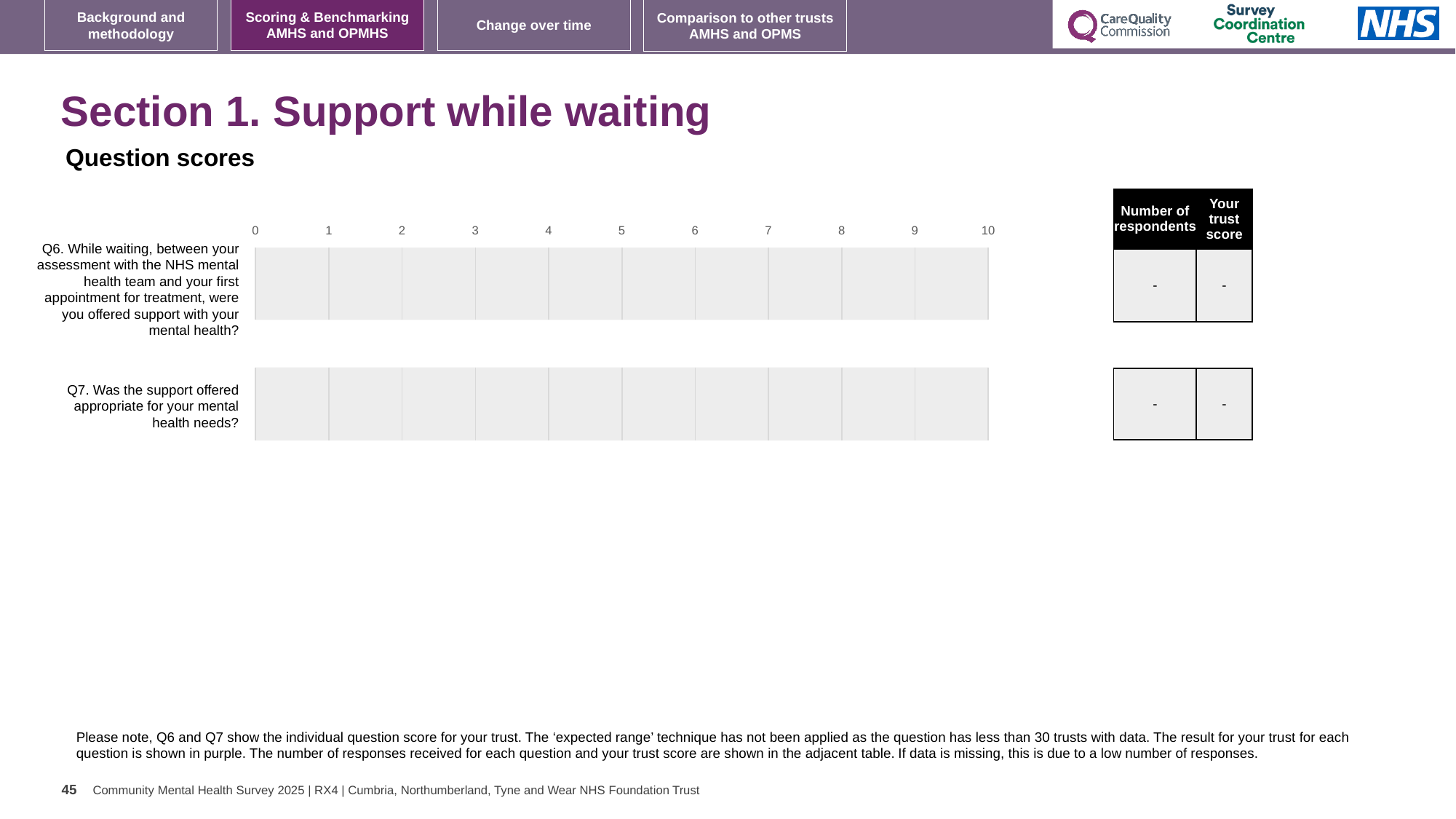
What is shown in the 'Your trust score' column for Q7 in the table next to the chart? - What is the highest value shown on the x axis of the 'Question scores' chart? 10 How many questions (categories) are listed on the 'Question scores' chart? 2 What kind of chart is shown under 'Question scores'? bar chart What is the lowest value shown on the x axis of the 'Question scores' chart? 0 What is shown in the 'Number of respondents' column for Q6 in the table next to the chart? -